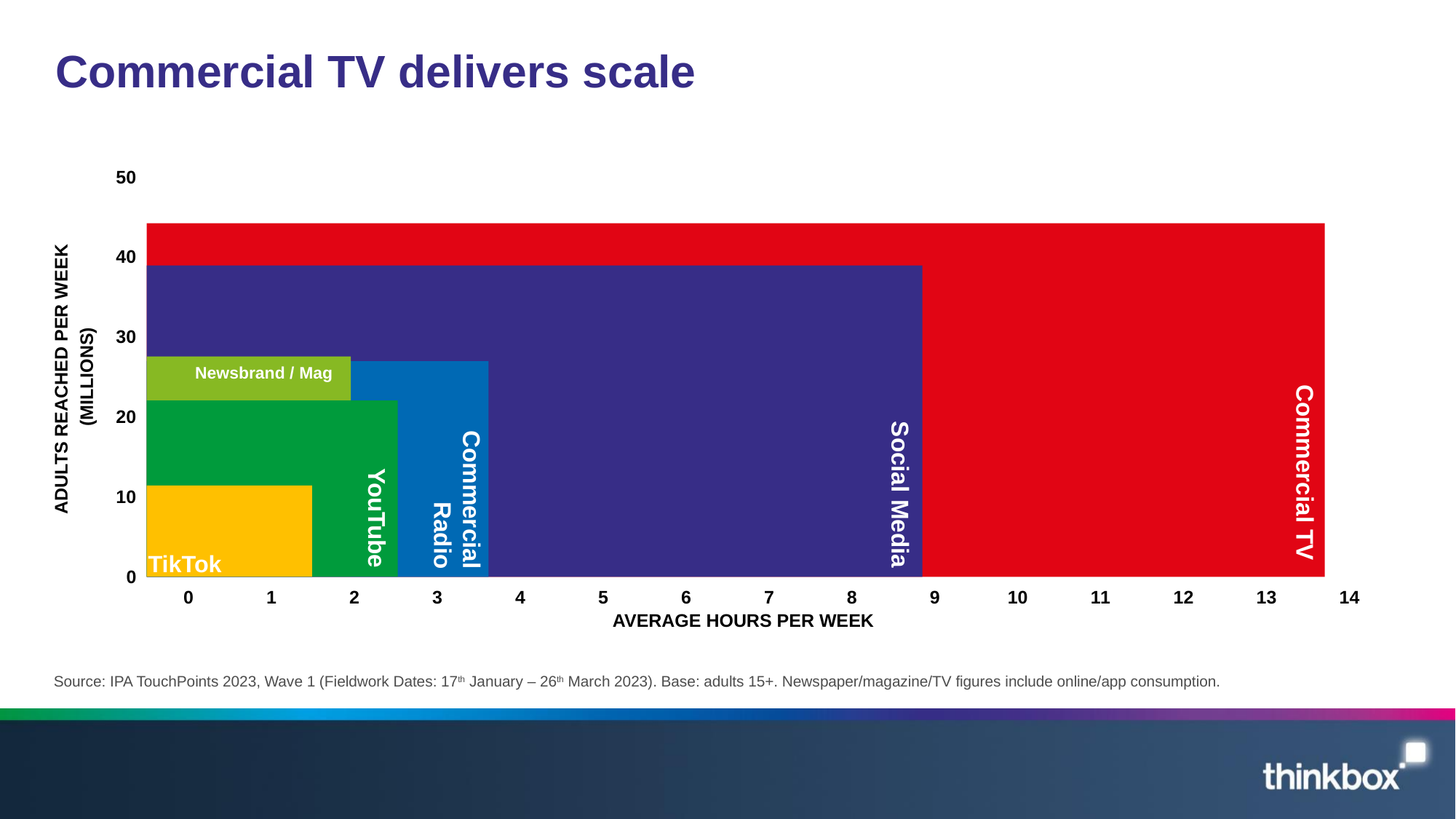
How many media categories are shown in the chart? 6 Which media category has the lowest average hours per week? TikTok Which reaches more adults per week, Social Media or Commercial Radio? Social Media Is the average hours per week for Commercial TV greater or less than 13? greater What is the title of the chart on the slide? Commercial TV delivers scale What is the label of the horizontal axis of the chart? AVERAGE HOURS PER WEEK Is the number of adults reached per week by Commercial TV greater or less than 40 million? greater Which media category reaches the most adults per week? Commercial TV Is the number of adults reached per week by TikTok greater or less than 10 million? greater Which media category has the highest average hours per week? Commercial TV Which media category reaches the fewest adults per week? TikTok